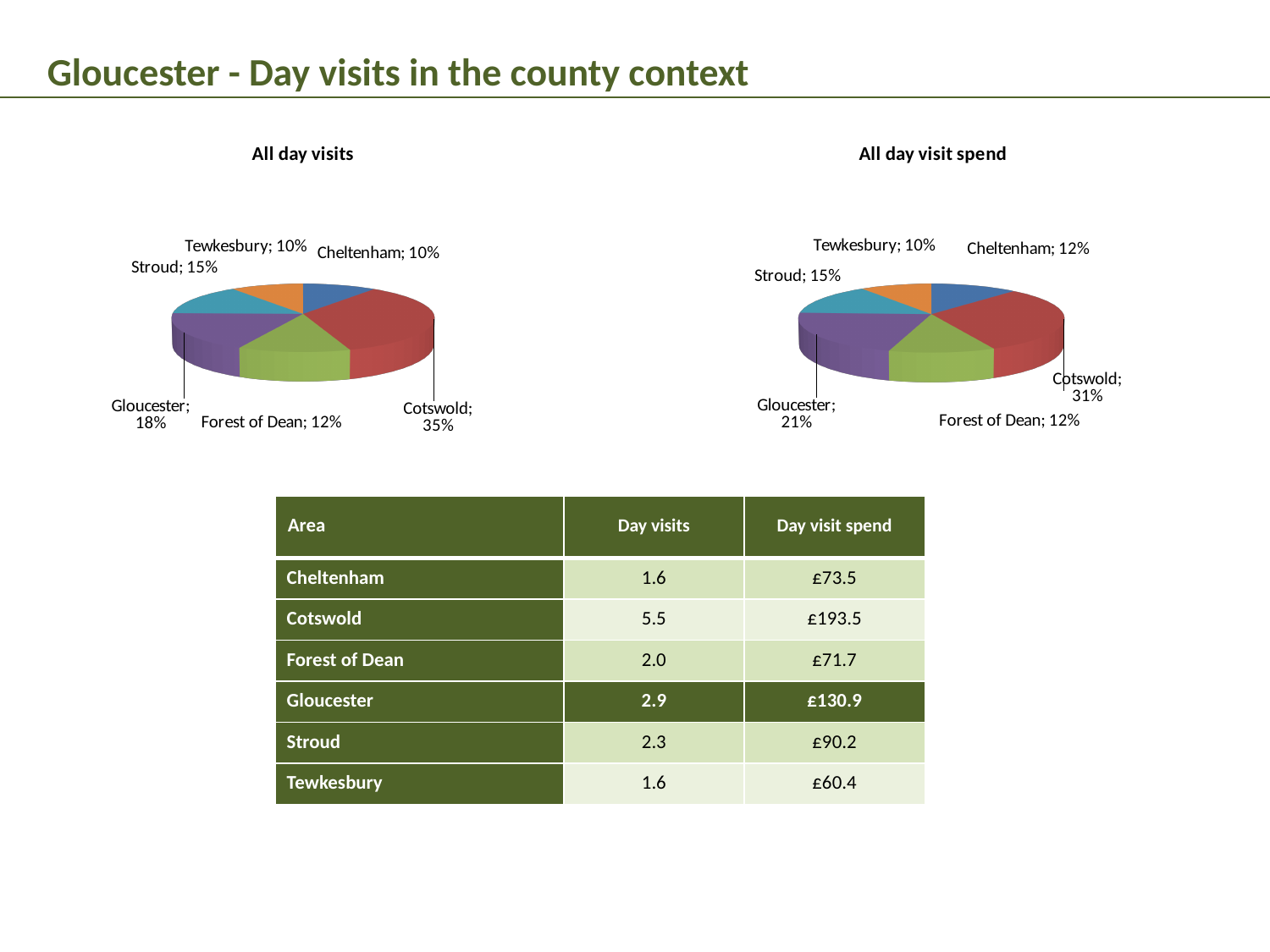
In the 'All day visits' pie chart, what share does Cotswold have? 35% What is the title of the pie chart on the left of the slide? All day visits In the 'All day visit spend' pie chart, which area has the smallest share? Tewkesbury What type of chart is the 'All day visit spend' chart? Pie chart In the 'All day visit spend' pie chart, which is larger: the share for Gloucester or the share for Stroud? Gloucester In the 'All day visits' pie chart, what share does Forest of Dean have? 12% In the 'All day visit spend' pie chart, what share does Gloucester have? 21% In the 'All day visits' pie chart, what is the difference between the Cotswold share and the Gloucester share? 17% In the 'All day visits' pie chart, which area has the largest share? Cotswold In the 'All day visit spend' pie chart, what is the difference between the Cotswold share and the Forest of Dean share? 19% In the 'All day visit spend' pie chart, what share does Cheltenham have? 12% How many slices does the 'All day visits' pie chart have? 6